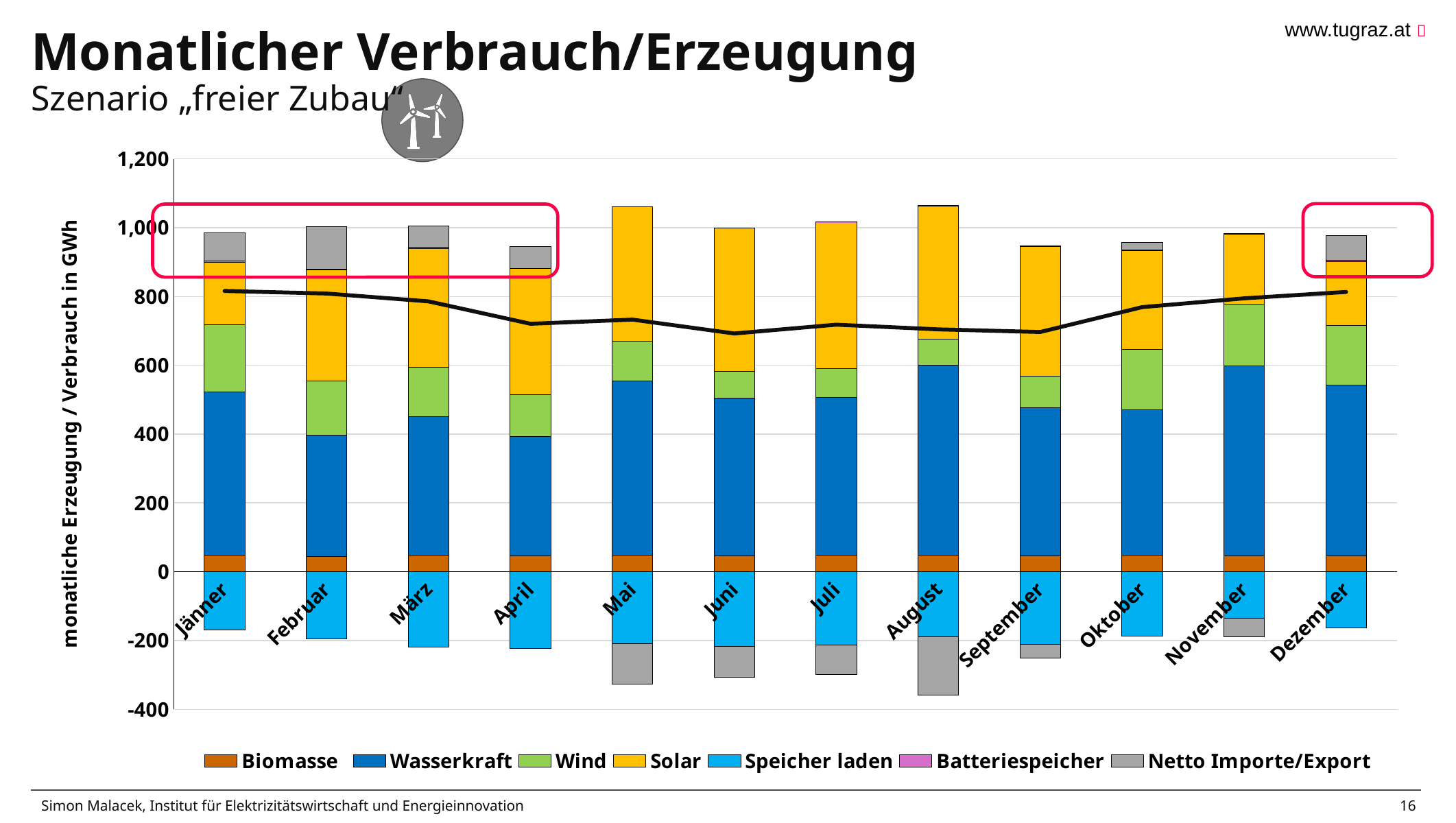
Is the top of the stacked bar for Mai greater or less than 1,000? greater Is the Solar segment larger in Mai or in Jänner? Mai How many series does the legend list? 7 What is the label of the y axis? monatliche Erzeugung / Verbrauch in GWh Which legend entry is shown in dark blue? Wasserkraft Is the Wasserkraft segment larger in August or in April? August Is the top of the stacked bar for September greater or less than 1,000? less What kind of chart is shown on the slide? Stacked bar chart with a line Does the black line rise or fall from Jänner to April? fall How many months (categories) are shown on the x axis? 12 Which month has the most negative (lowest) bar bottom? August Is the bottom of the negative stack for August greater or less than -200? less